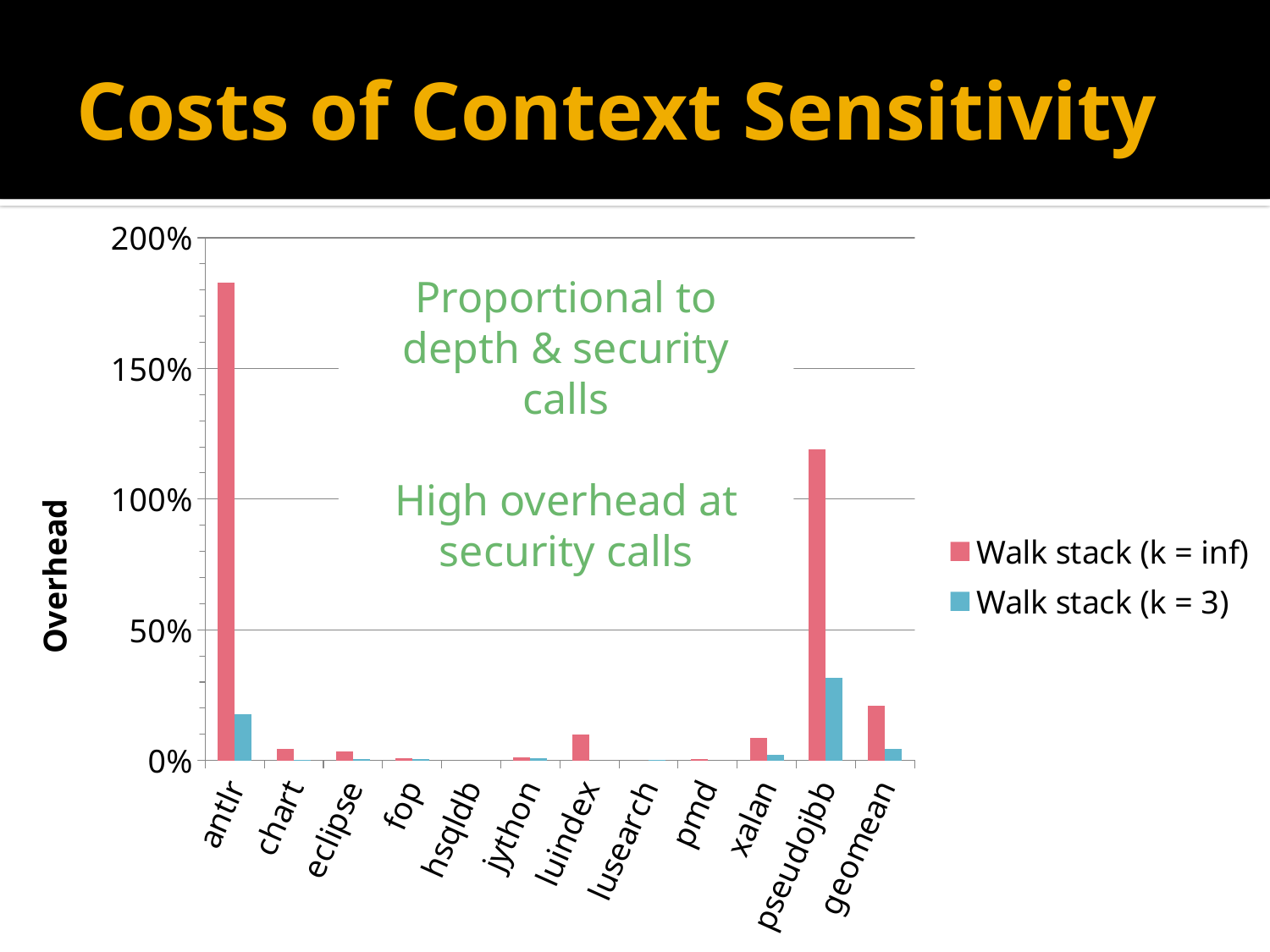
Is the Walk stack (k = inf) value for geomean greater or less than 50%? less Which category has the highest overhead for the Walk stack (k = 3) series? pseudojbb Is the Walk stack (k = 3) value for pseudojbb greater or less than 50%? less What kind of chart is shown on the slide? bar chart Is the Walk stack (k = inf) value for antlr greater or less than 150%? greater For antlr, which series has the larger overhead: Walk stack (k = inf) or Walk stack (k = 3)? Walk stack (k = inf) What is the label on the y axis? Overhead Which category has the highest overhead for the Walk stack (k = inf) series? antlr How many benchmark categories are shown on the x axis? 12 How many series does the legend list? 2 For the Walk stack (k = inf) series, which is larger: antlr or pseudojbb? antlr